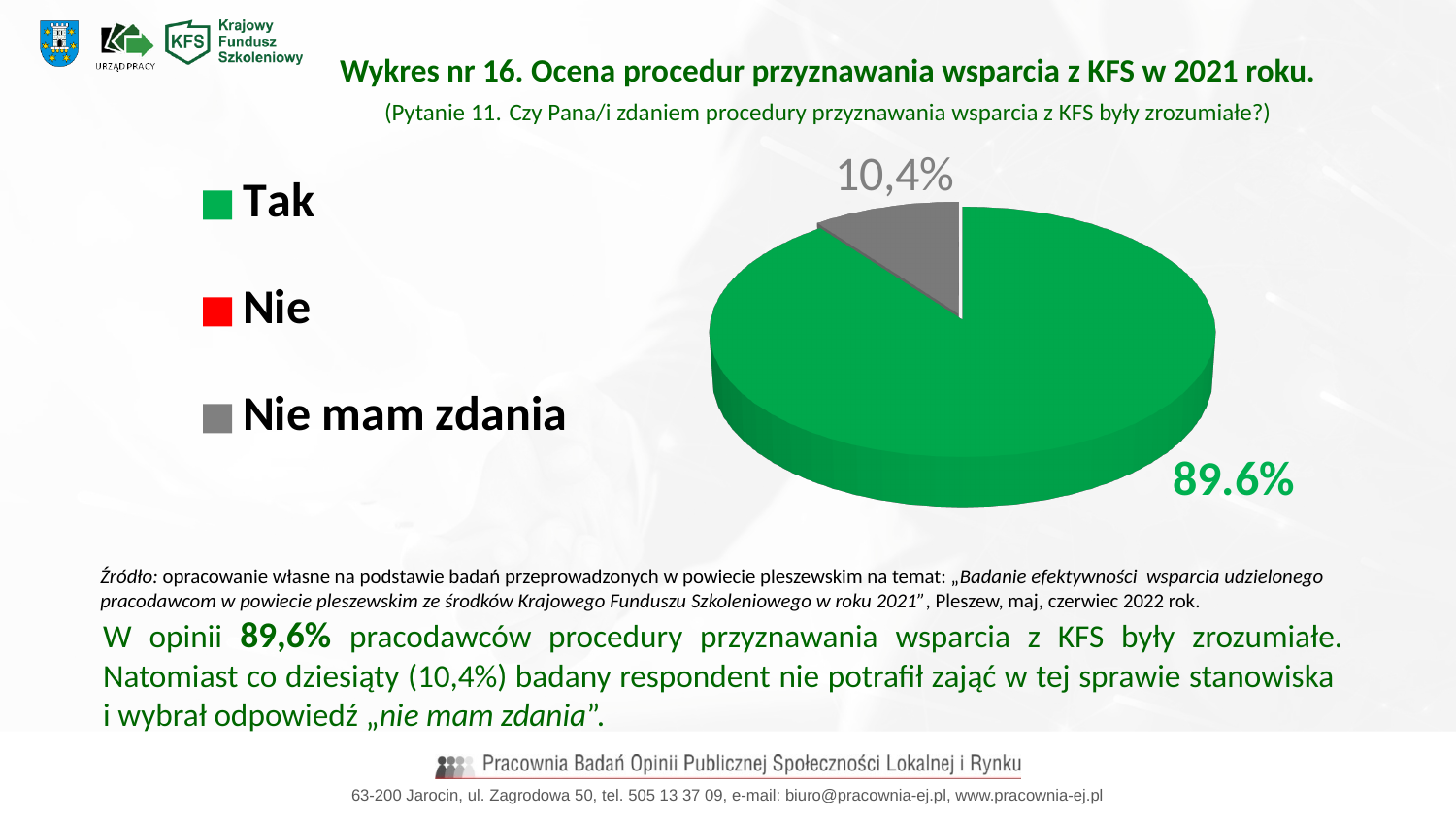
What percentage of respondents answered "Nie mam zdania"? 10,4% What colour is used for the "Tak" category in the chart? Green What is the difference in percentage points between the "Tak" slice and the "Nie mam zdania" slice? 79,2 How many entries does the legend of the chart list? 3 Which answer category has the largest slice of the pie? Tak Is the value for "Tak" greater or less than 50%? greater Which is larger, the slice for "Tak" or the slice for "Nie mam zdania"? Tak What type of chart is shown on the slide? Pie chart What percentage of respondents answered "Tak" in the pie chart? 89.6% What is the number of the chart given in its title? Wykres nr 16 How many slices are visible in the pie chart? 2 What share of the pie does the grey slice represent? 10,4%